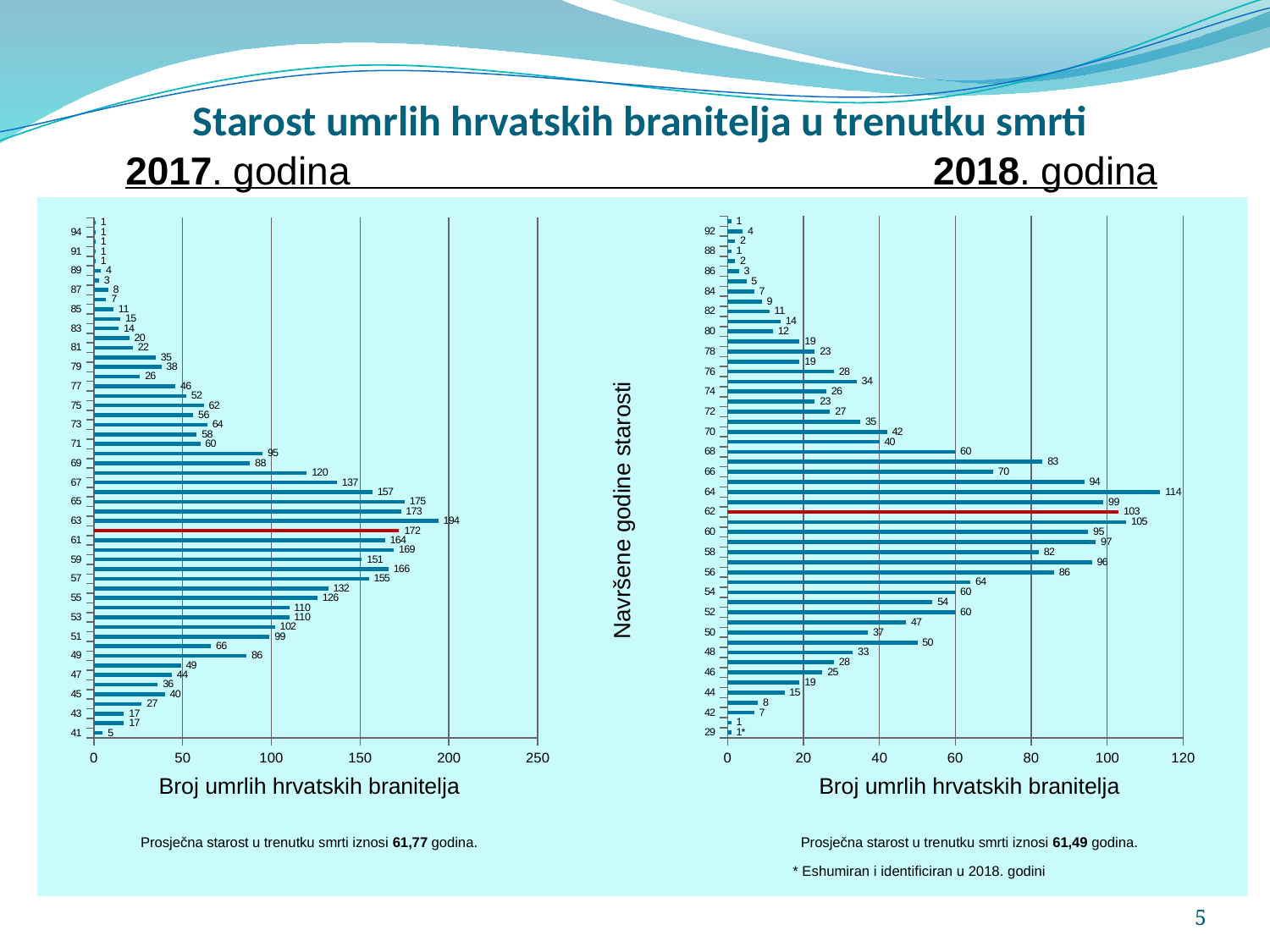
In the 2017. godina chart, what is the value of the red bar at age 62? 172 What is the x-axis title of the 2018. godina chart? Broj umrlih hrvatskih branitelja What kind of chart is used for the 2017. godina data? bar chart In the 2018. godina chart, which age has the highest number of deceased veterans? 64 In the 2017. godina chart, is the value for age 67 greater or less than 100? greater In the 2017. godina chart, what is the difference between the values for age 63 and age 65? 19 In the 2018. godina chart, what is the value for age 64? 114 In the 2017. godina chart, what is the value for age 63? 194 In the 2017. godina chart, what is the value for age 41? 5 In the 2018. godina chart, what is the value of the red bar at age 62? 103 In the 2018. godina chart, which is larger, the value for age 66 or the value for age 68? age 66 In the 2017. godina chart, which age has the highest number of deceased veterans? 63